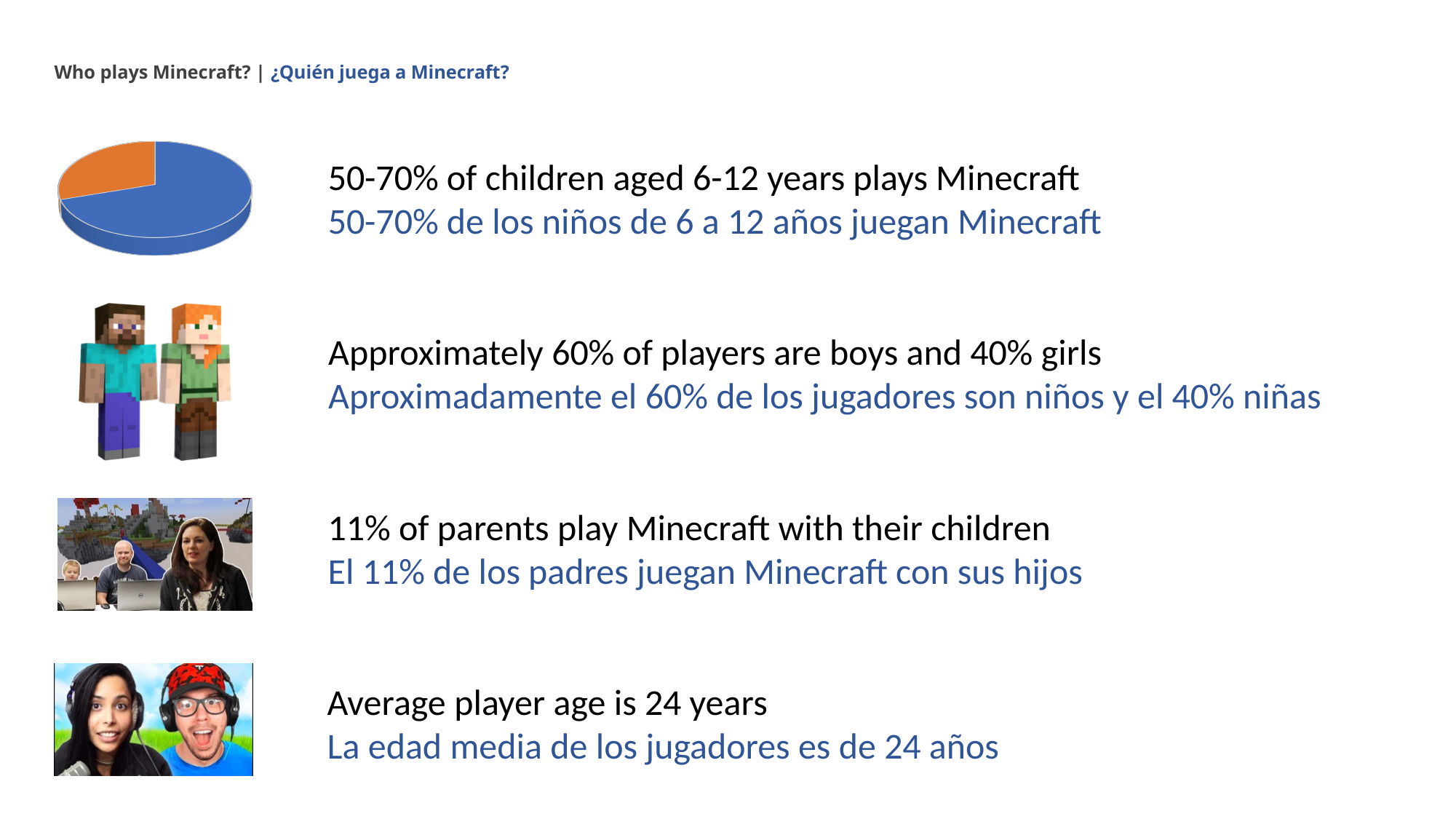
What two colours are used for the slices of the pie chart? Blue and orange Which slice of the pie chart is larger, the blue one or the orange one? The blue one What kind of chart is shown on the slide? Pie chart Which colour is the smallest slice of the pie chart? Orange Does the pie chart have a legend? No Which colour is the largest slice of the pie chart? Blue How many slices does the pie chart have? 2